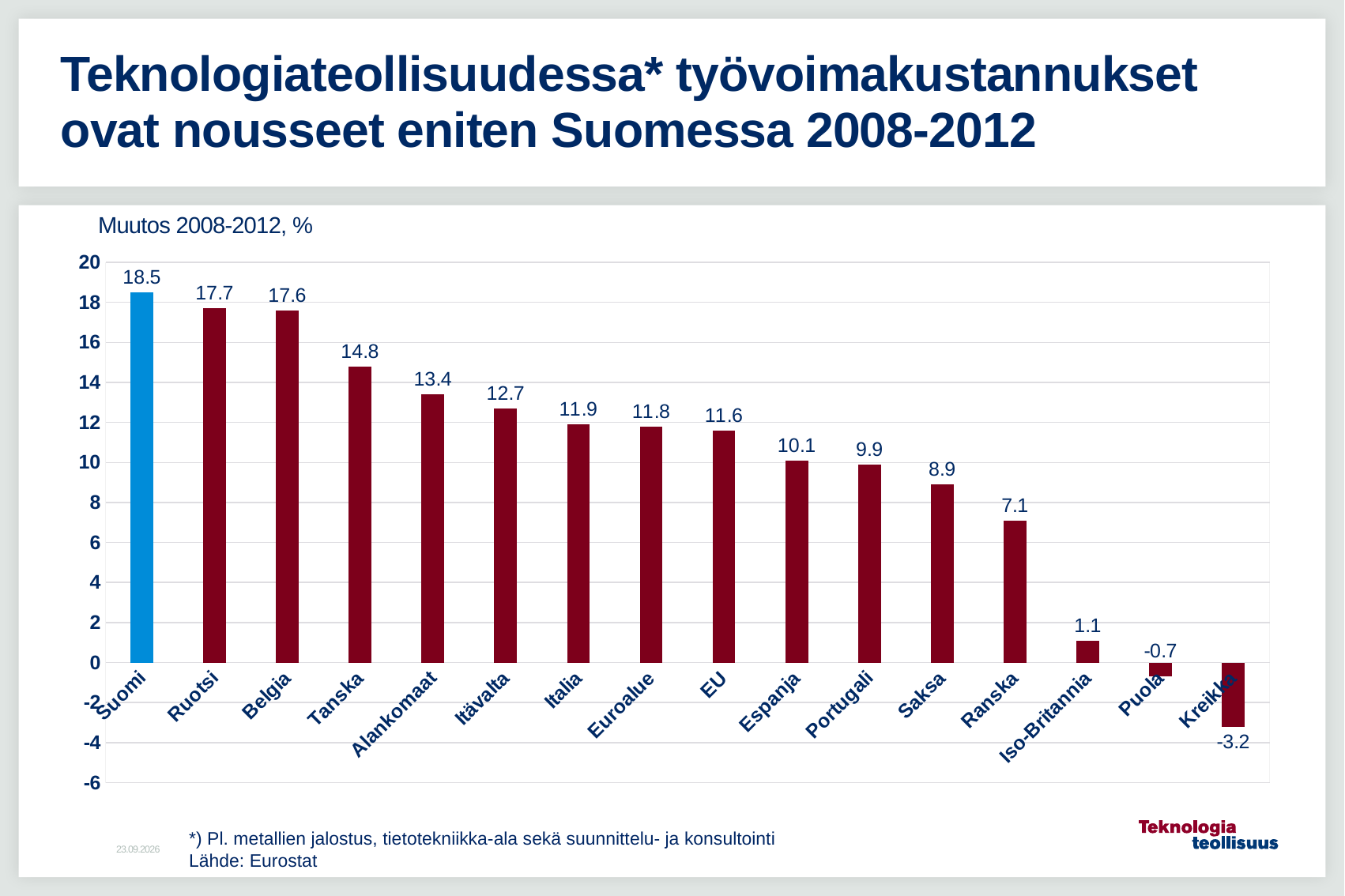
What is the value shown for Kreikka? -3.2 Which category has the highest value? Suomi How many categories are shown on the x axis? 16 What is the value shown for Saksa? 8.9 Which category has the lowest value? Kreikka What is the label shown above the chart describing the plotted measure? Muutos 2008-2012, % What is the difference between the values for Suomi and Ruotsi? 0.8 Do the values generally rise or fall from left to right along the x axis? Fall Which is larger, the value for Espanja or the value for Saksa? Espanja What kind of chart is shown on the slide? Bar chart What is the value shown for Suomi? 18.5 What is the difference between the values for Tanska and Ranska? 7.7